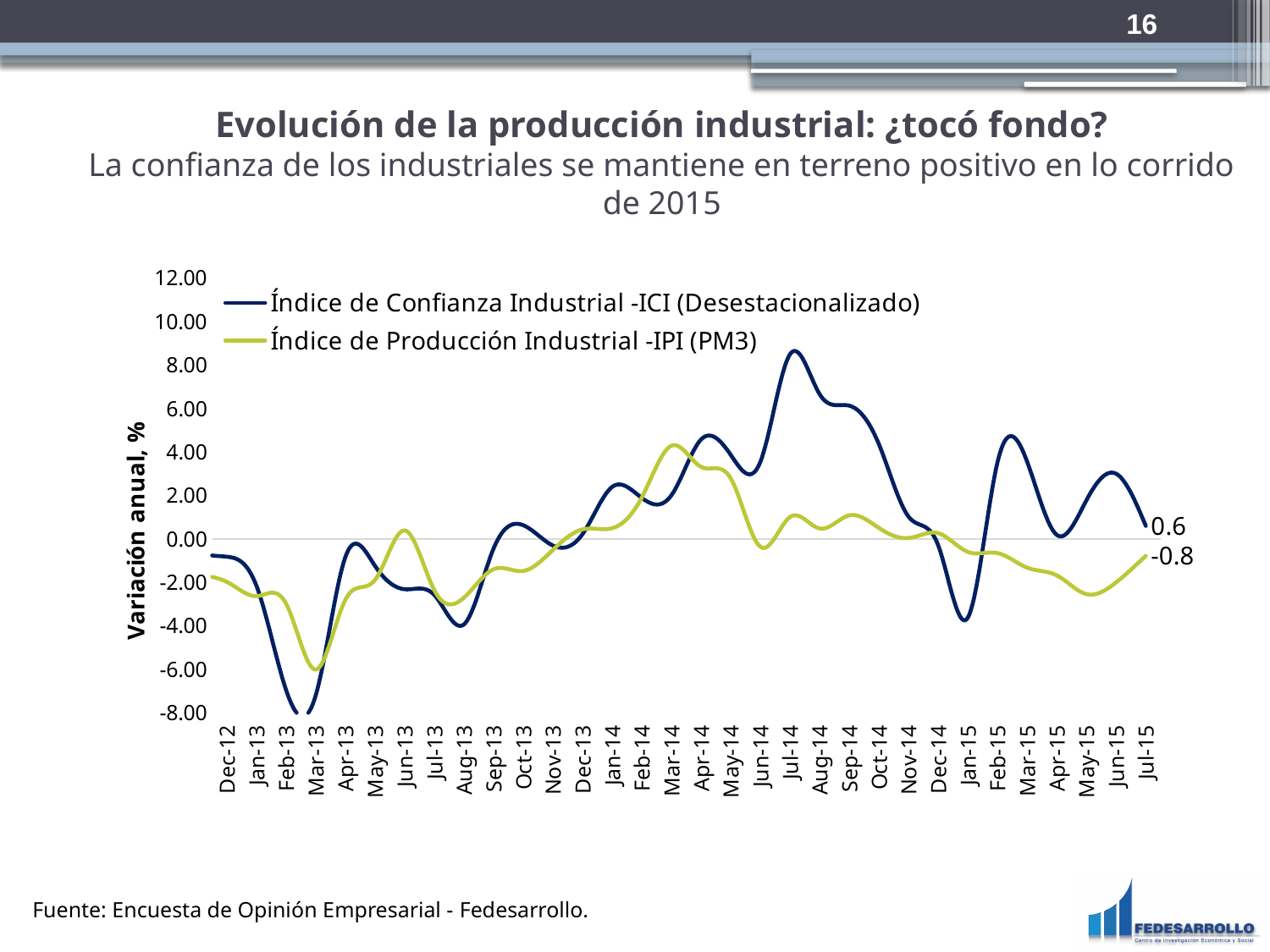
Is the value of the IPI series in Mar-13 greater or less than -4.00? less Is the value of the ICI series in Feb-13 greater or less than -6.00? less In Jul-15, which series has the larger value, the ICI or the IPI? Índice de Confianza Industrial -ICI (Desestacionalizado) Is the value of the ICI series in Jul-14 greater or less than 6.00? greater Does the ICI series rise or fall from Jun-15 to Jul-15? Fall What is the value of the Índice de Producción Industrial -IPI (PM3) in Jul-15? -0.8 How many series does the legend list? 2 What is the value of the Índice de Confianza Industrial -ICI (Desestacionalizado) in Jul-15? 0.6 What is the difference between the ICI value and the IPI value in Jul-15? 1.4 In which month does the ICI series reach its highest value? Jul-14 What kind of chart is shown on the slide? Line chart What is the label of the vertical axis? Variación anual, %